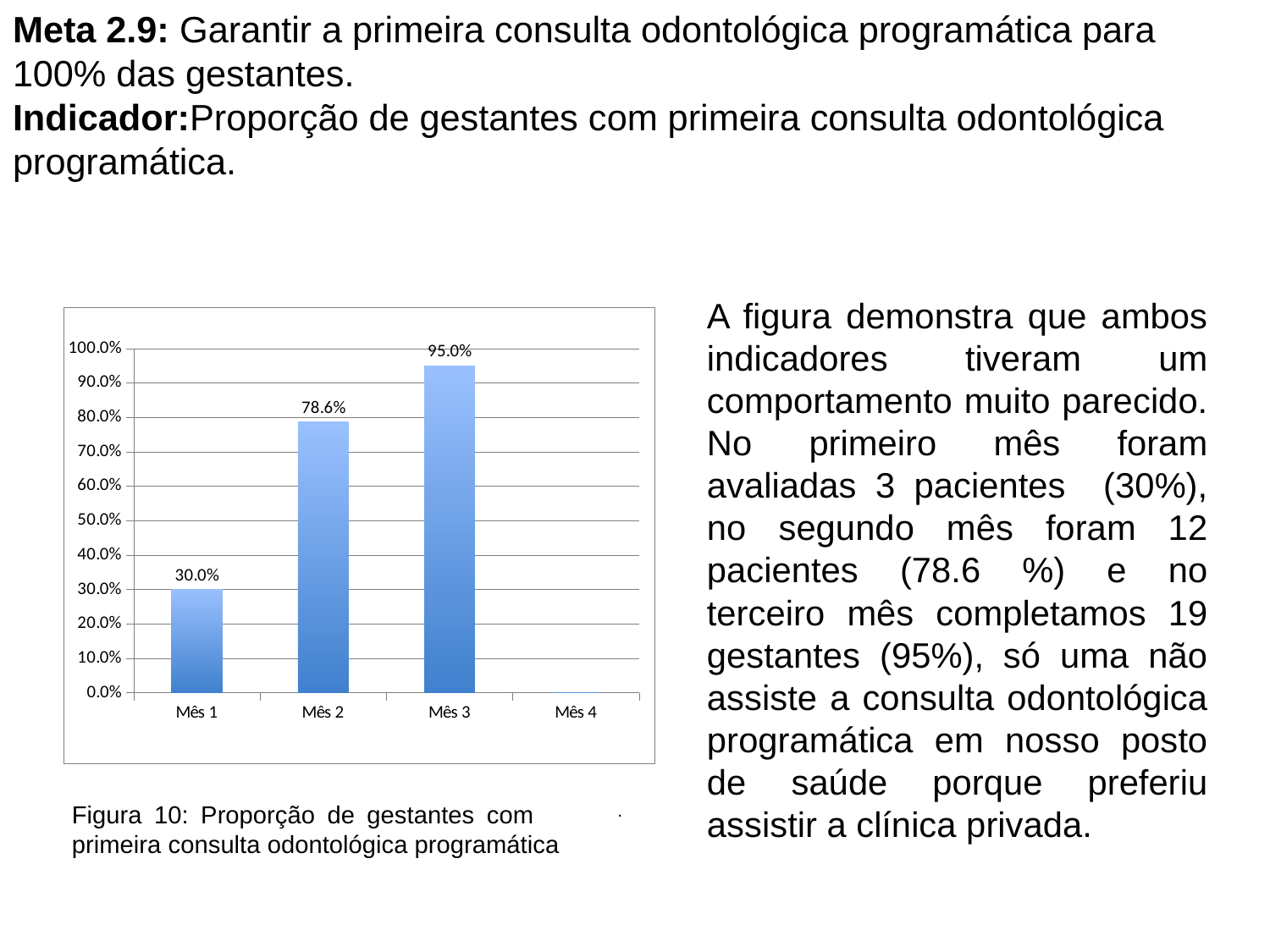
Do the values rise or fall from Mês 1 to Mês 3? Rise Which is larger, the value for Mês 2 or the value for Mês 3? Mês 3 What figure number is given in the caption below the chart? Figura 10 What is the value for Mês 3? 95.0% What is the difference between the values for Mês 3 and Mês 1? 65.0% What kind of chart is shown? Bar chart What is the value for Mês 2? 78.6% How many month categories are shown on the x axis? 4 Which month has the highest value? Mês 3 Among the months with a data label, which has the lowest value? Mês 1 What is the difference between the values for Mês 2 and Mês 1? 48.6% What is the value for Mês 1? 30.0%